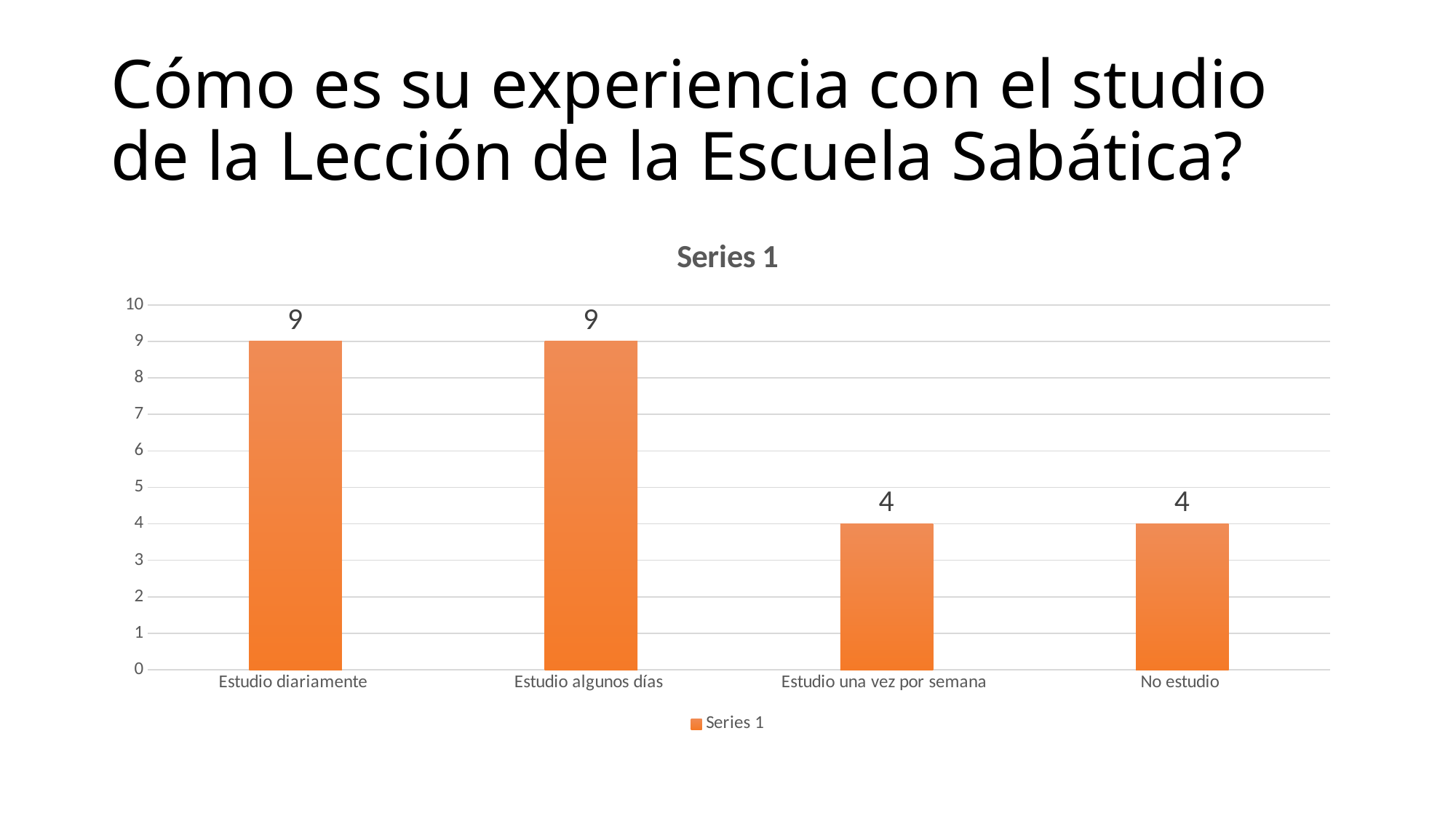
What is the value for Estudio una vez por semana? 4 How many series does the legend list? 1 How many categories are shown on the x axis? 4 Which is larger, the value for Estudio algunos días or the value for Estudio una vez por semana? Estudio algunos días What is the title of the chart? Series 1 What kind of chart is shown on the slide? bar chart What is the difference between the values for Estudio diariamente and No estudio? 5 Is the value for Estudio diariamente greater or less than 5? greater What is the value for Estudio algunos días? 9 What is the value for No estudio? 4 What is the value for Estudio diariamente? 9 Is the value for No estudio greater or less than 5? less